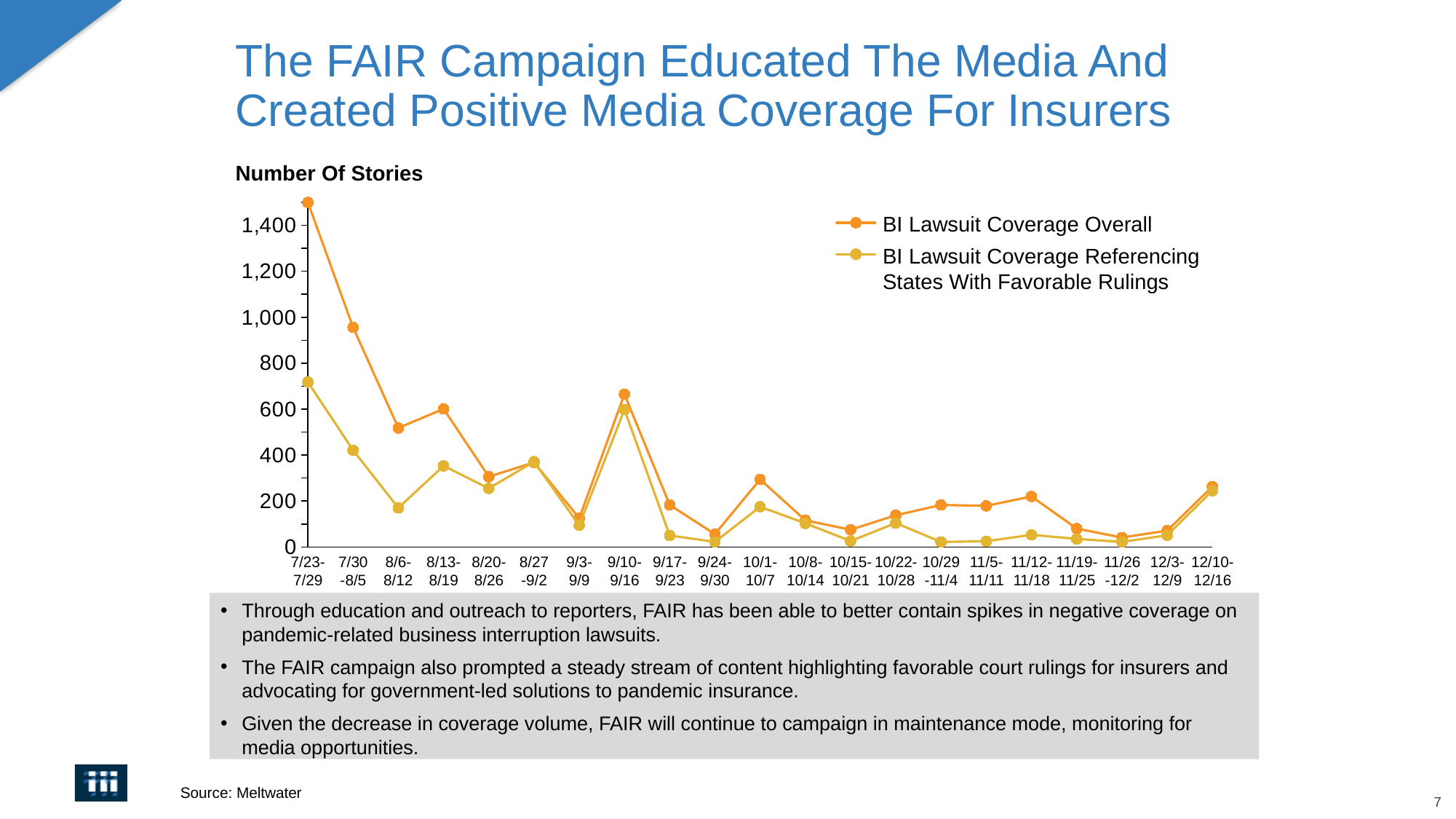
What kind of chart is shown on the slide? Line chart Is the value for BI Lawsuit Coverage Overall in 9/10-9/16 greater or less than 600? greater In which period is BI Lawsuit Coverage Overall highest? 7/23-7/29 Is the value for BI Lawsuit Coverage Referencing States With Favorable Rulings in 8/6-8/12 greater or less than 200? less Is the value for BI Lawsuit Coverage Overall in 7/23-7/29 greater or less than 1,400? greater In which period is BI Lawsuit Coverage Referencing States With Favorable Rulings highest? 7/23-7/29 In 7/30-8/5, which series has the larger value: BI Lawsuit Coverage Overall or BI Lawsuit Coverage Referencing States With Favorable Rulings? BI Lawsuit Coverage Overall How many weekly periods are plotted along the x axis? 21 What is the label shown above the y axis of the chart? Number Of Stories How many series does the legend list? 2 Does BI Lawsuit Coverage Overall rise or fall from 7/23-7/29 to 8/6-8/12? Fall